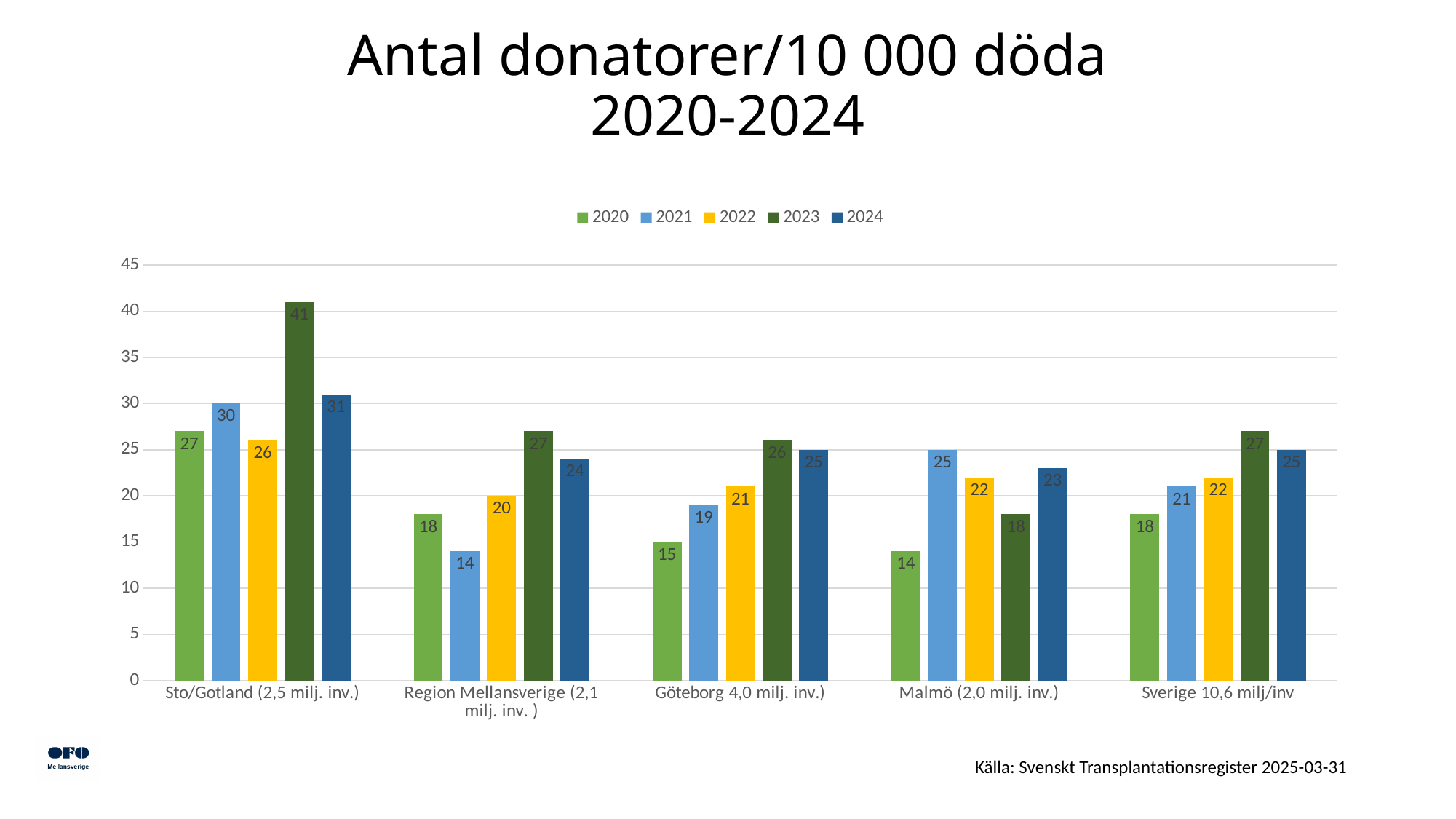
What is the value for Malmö (2,0 milj. inv.) in 2021? 25 How many categories are shown on the x axis? 5 What kind of chart is shown on the slide? Bar chart Which category has the highest value in 2023? Sto/Gotland (2,5 milj. inv.) What is the value for Sverige 10,6 milj/inv in 2024? 25 What is the value for Göteborg 4,0 milj. inv. in 2020? 15 What is the title of the chart? Antal donatorer/10 000 döda 2020-2024 How many series does the legend list? 5 Which category has the lowest value in 2021? Region Mellansverige (2,1 milj. inv. ) Which is larger for Malmö (2,0 milj. inv.): the 2022 value or the 2023 value? 2022 What is the value for Sto/Gotland (2,5 milj. inv.) in 2023? 41 What is the difference between the 2023 and 2024 values for Sto/Gotland (2,5 milj. inv.)? 10